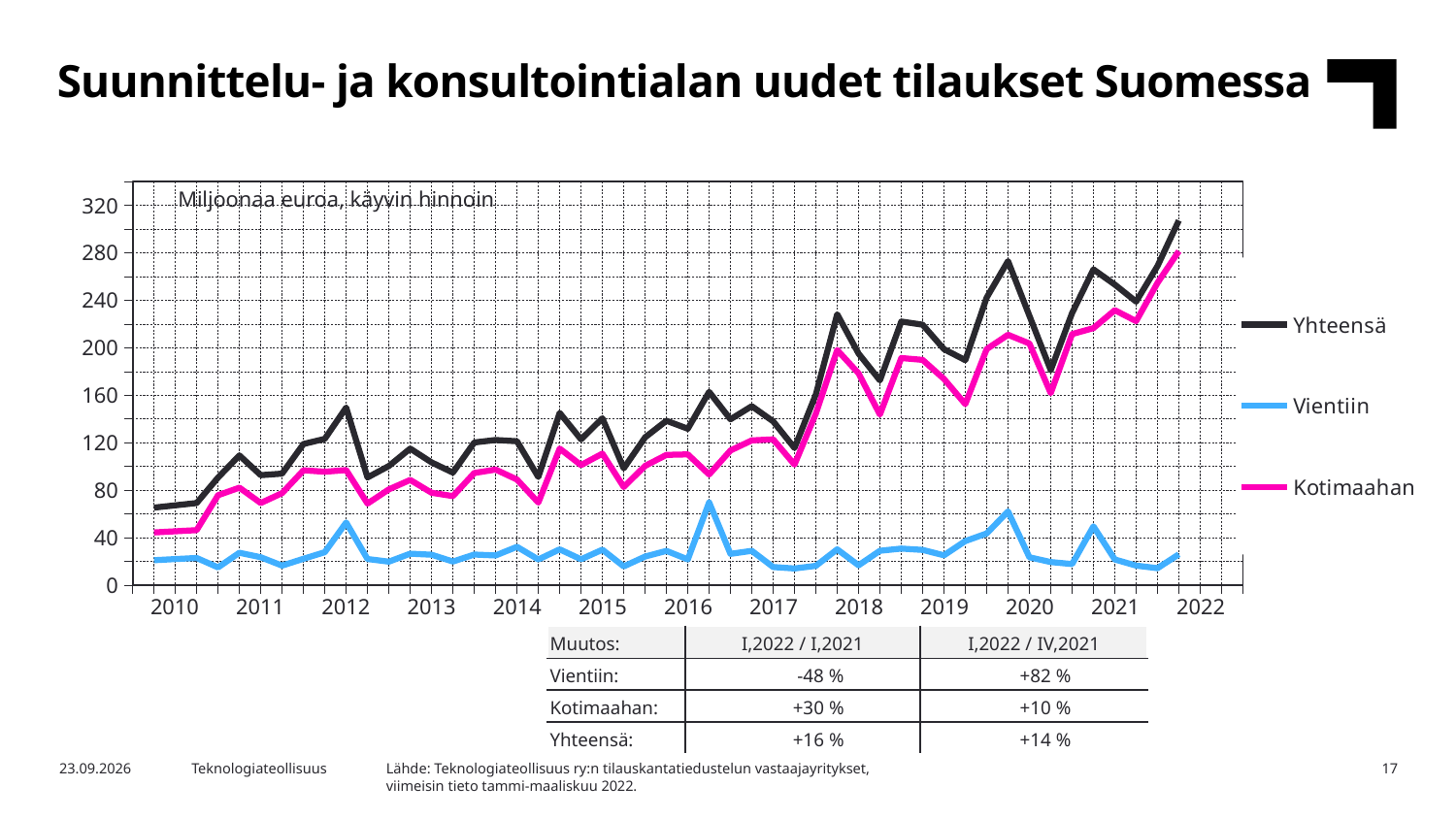
Is the peak value for Vientiin in 2016 greater or less than 40? greater Which series has the lowest values across the whole chart? Vientiin At the last point in 2022, which is larger, Kotimaahan or Vientiin? Kotimaahan Is the value for Yhteensä at the last point in 2022 greater or less than 280? greater Which series has the highest values across the whole chart? Yhteensä How many year labels are shown on the x axis? 13 What kind of chart is shown on the slide? line chart How many series does the legend list? 3 Which series is plotted with the black line? Yhteensä What unit label is printed inside the chart area? Miljoonaa euroa, käyvin hinnoin Is the value for Yhteensä at the first point in 2010 greater or less than 80? less Does the Yhteensä line overall rise or fall from 2010 to 2022? rise